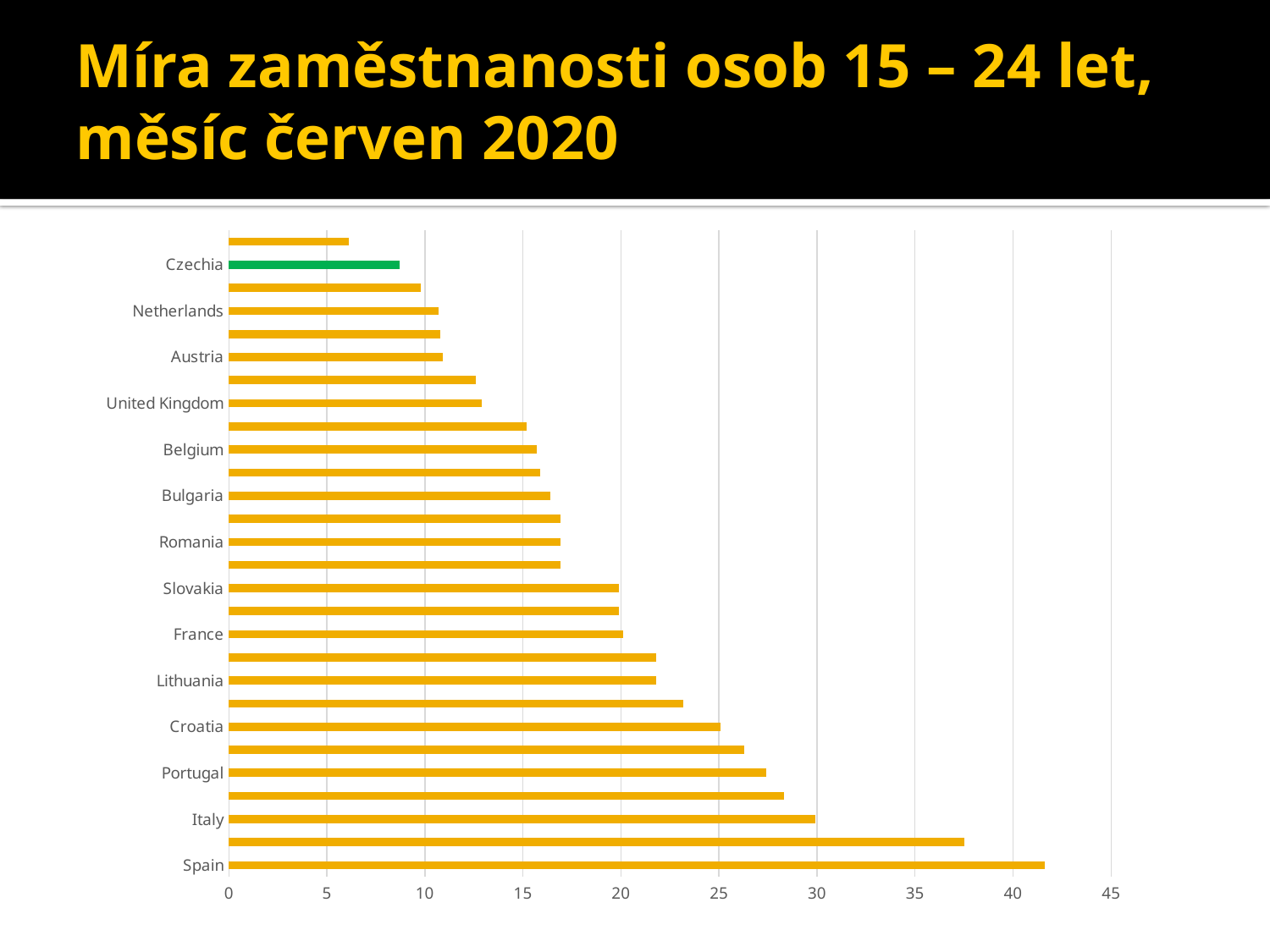
Is the value for Czechia greater or less than 10? less Is the value for Lithuania greater or less than 20? greater Which has the larger value, Italy or Spain? Spain Is the value for United Kingdom greater or less than 15? less Which has the larger value, Czechia or Portugal? Portugal Which country has the highest employment rate in the chart? Spain Which country's bar is shown in green rather than yellow? Czechia How many bars are plotted in the chart? 28 What kind of chart is shown on the slide? bar chart